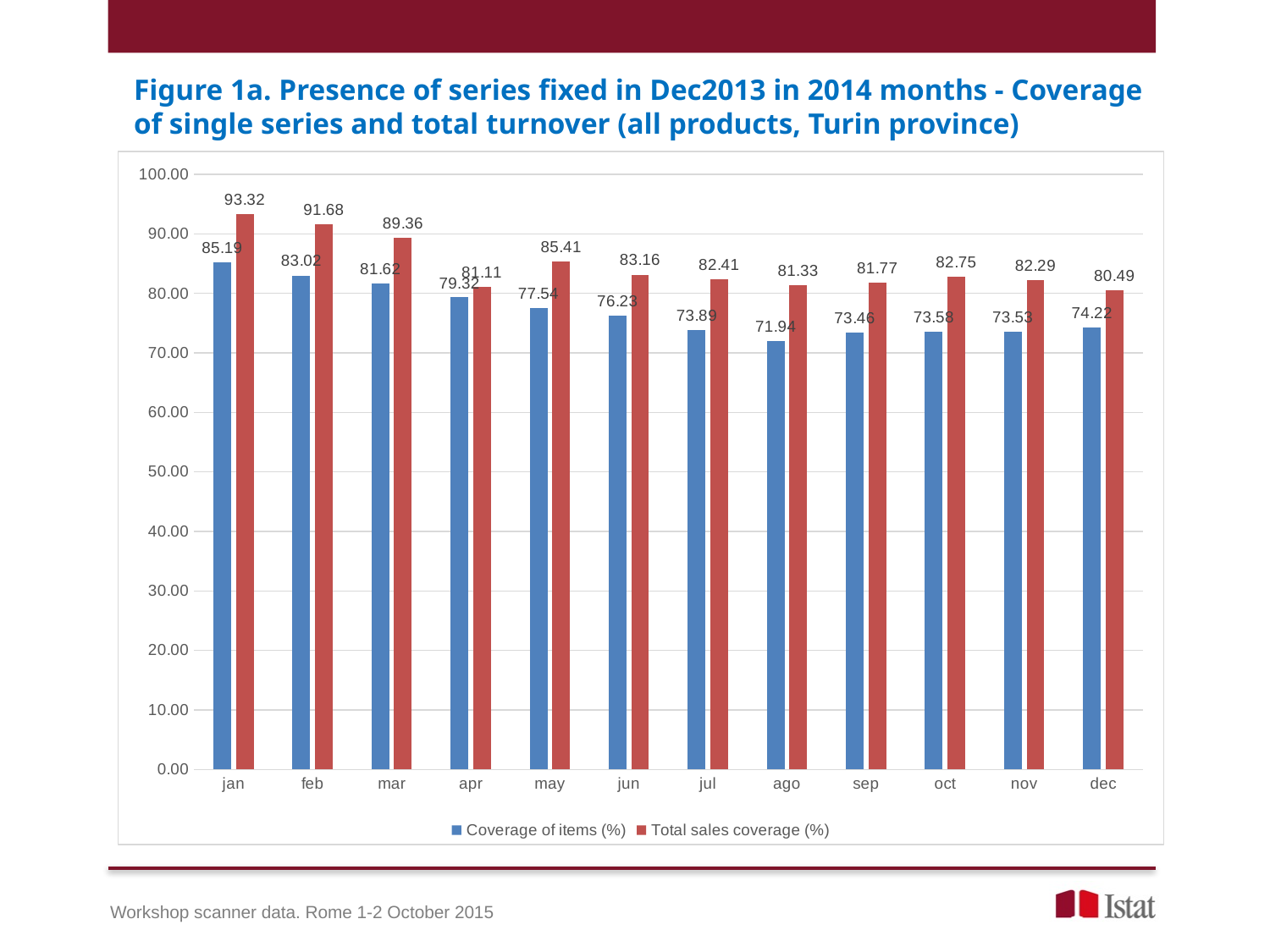
What kind of chart is shown? bar chart What is the difference between Total sales coverage (%) and Coverage of items (%) in jan? 8.13 Is the Coverage of items (%) value for jul greater or less than 80.00? less Which month has the highest Total sales coverage (%)? jan What is the Coverage of items (%) value for ago? 71.94 What is the Coverage of items (%) value for jan? 85.19 Does the Total sales coverage (%) rise or fall from jan to apr? fall Which is larger in dec: Coverage of items (%) or Total sales coverage (%)? Total sales coverage (%) How many series does the legend list? 2 What is the Total sales coverage (%) value for may? 85.41 Which month has the lowest Coverage of items (%)? ago How many months are shown on the x axis? 12